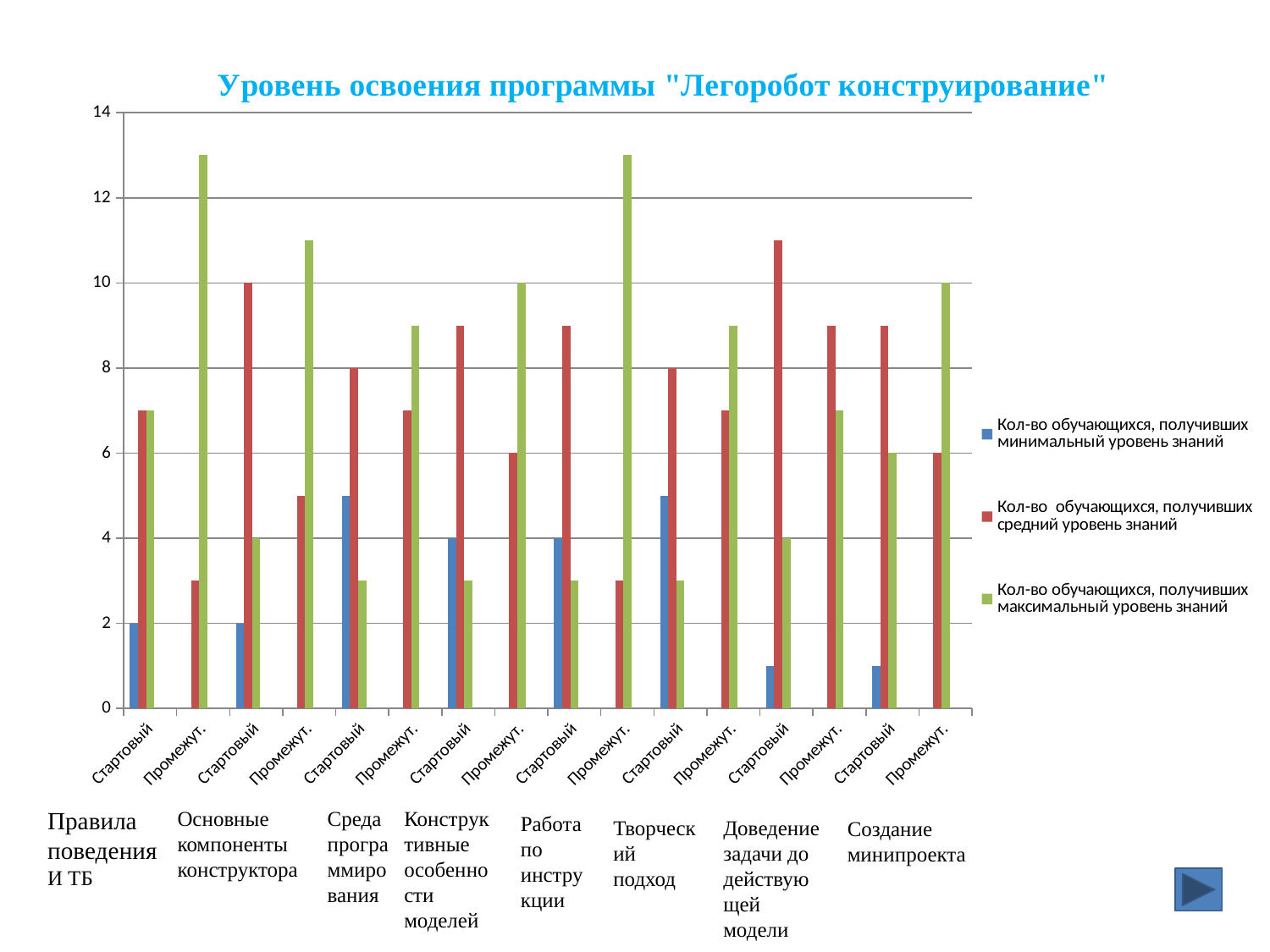
Is the red (средний уровень знаний) value for the Стартовый bar of "Доведение задачи до действующей модели" greater or less than 10? greater For the Промежут. bar of "Правила поведения и ТБ", which series is larger: the red (средний уровень) or the green (максимальный уровень)? green (максимальный уровень знаний) For the Стартовый bar of "Основные компоненты конструктора", what is the difference between the red (средний уровень) value and the blue (минимальный уровень) value? 8 What type of chart is shown on the slide? bar chart How many series does the legend list? 3 What is the value of the green series (максимальный уровень знаний) for the Стартовый bar of "Создание минипроекта"? 6 What is the value of the red series (средний уровень знаний) for the Стартовый bar of "Основные компоненты конструктора"? 10 What is the title of the chart? Уровень освоения программы "Легоробот конструирование" What is the value of the blue series (минимальный уровень знаний) for the Стартовый bar of "Правила поведения и ТБ"? 2 What is the value of the green series (максимальный уровень знаний) for the Промежут. bar of "Создание минипроекта"? 10 How many bar groups (x-axis categories) are plotted along the x axis? 16 Is the green (максимальный уровень знаний) value for the Промежут. bar of "Правила поведения и ТБ" greater or less than 12? greater